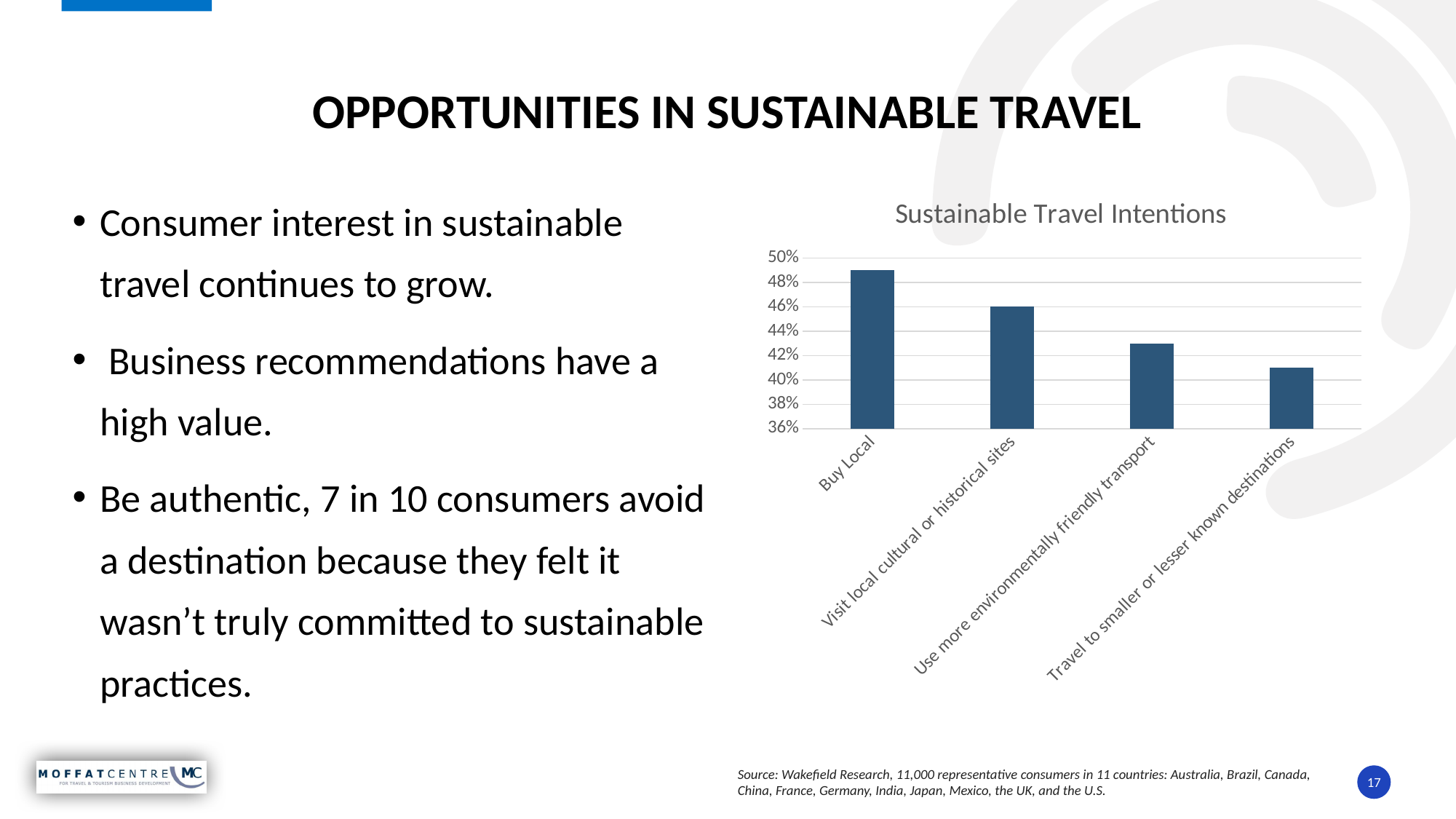
Which category has the highest value in the chart? Buy Local Which category has the lowest value in the chart? Travel to smaller or lesser known destinations What is the title of the chart? Sustainable Travel Intentions What is the value for Visit local cultural or historical sites? 46% Do the values rise or fall moving from left to right across the categories? fall Which is larger: the value for Buy Local or the value for Use more environmentally friendly transport? Buy Local What is the lowest value shown on the vertical axis of the chart? 36% Is the value for Travel to smaller or lesser known destinations greater or less than 40%? greater Is the value for Use more environmentally friendly transport greater or less than 44%? less Is the value for Buy Local greater or less than 48%? greater How many categories are plotted in the chart? 4 What kind of chart is shown on the slide? bar chart